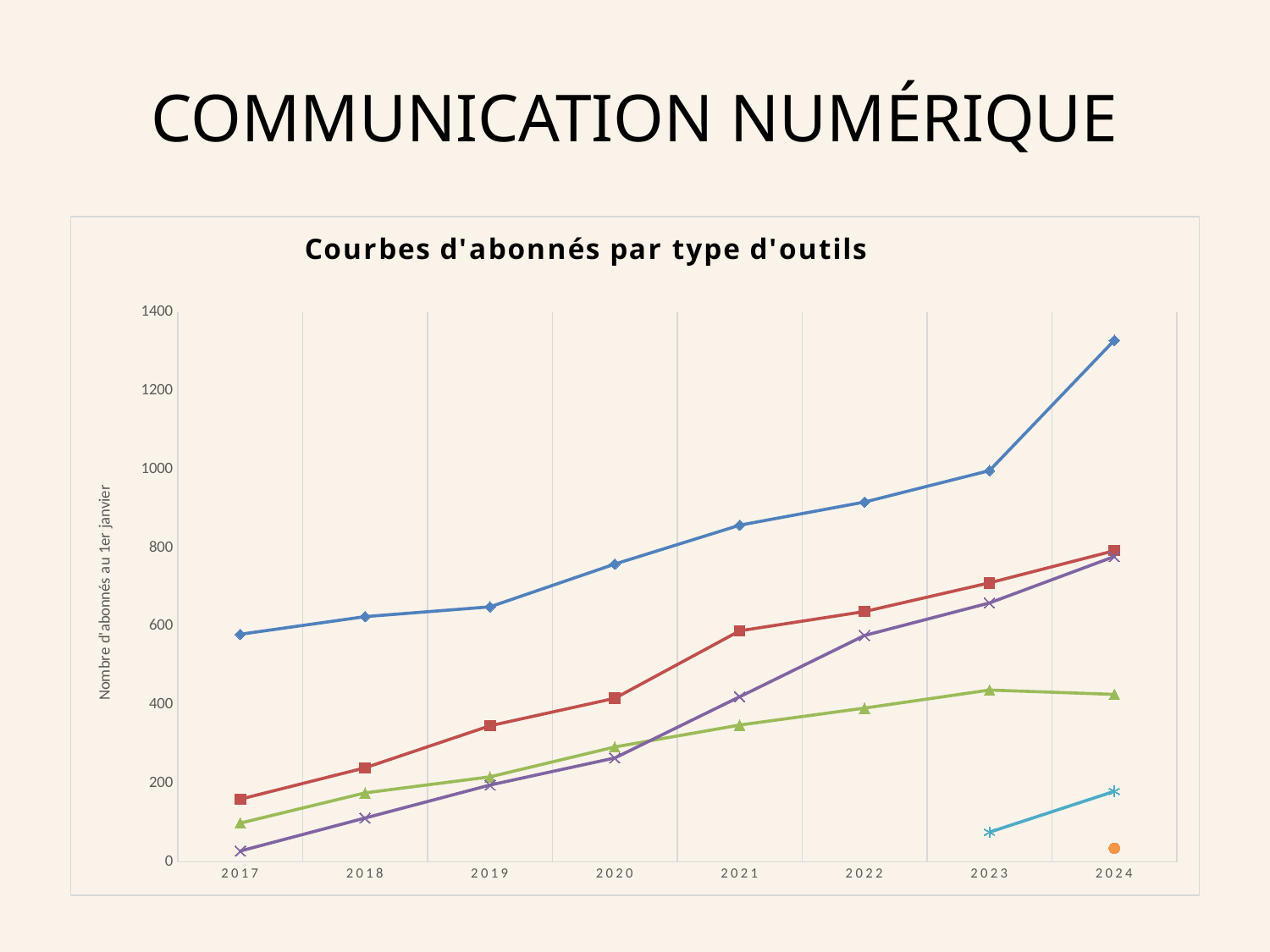
In which year does the blue diamond line reach its highest value? 2024 Is the value of the blue diamond line in 2020 greater or less than 700? greater What is the label of the vertical axis? Nombre d'abonnés au 1er janvier What is the title of the chart? Courbes d'abonnés par type d'outils How many years are shown on the x axis? 8 What kind of chart is shown on the slide? line chart Is the value of the purple x line in 2022 greater or less than 400? greater Is the value of the blue diamond line in 2024 greater or less than 1200? greater Does the blue diamond line rise or fall from 2017 to 2024? rise